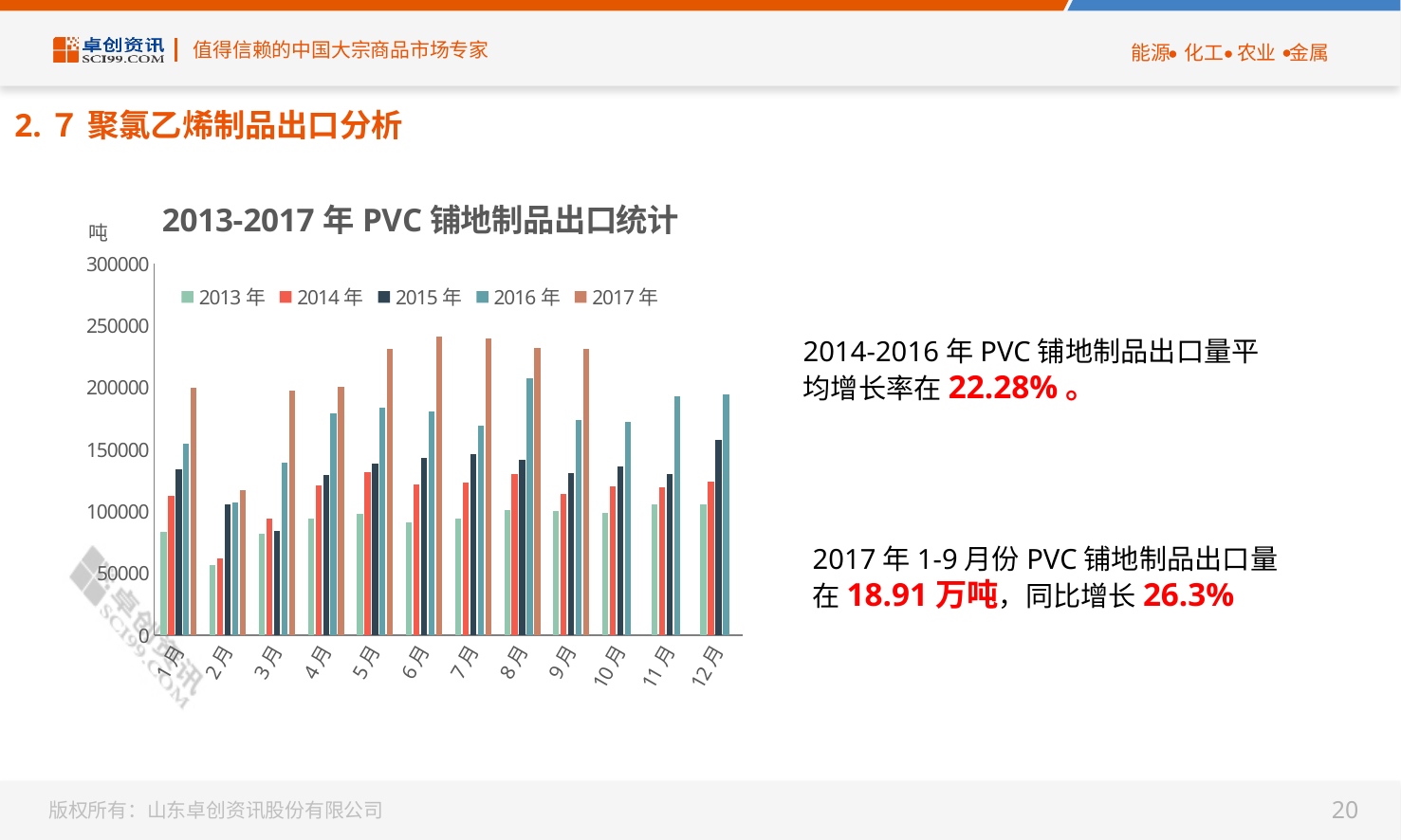
Is the value for 2016 年 in 8月 greater or less than 200000? greater How many month categories are shown on the x axis of the chart? 12 How many series does the legend of the chart list? 5 Is the value for 2013 年 in 2月 greater or less than 100000? less Is the value for 2017 年 in 6月 greater or less than 200000? greater In 1月, which is larger: the value for 2016 年 or the value for 2015 年? 2016 年 What unit is shown on the y axis of the chart? 吨 In which month is the 2016 年 value highest? 8月 In which month is the 2017 年 value lowest? 2月 What is the title of the chart? 2013-2017 年 PVC 铺地制品出口统计 What kind of chart is shown on the slide? bar chart